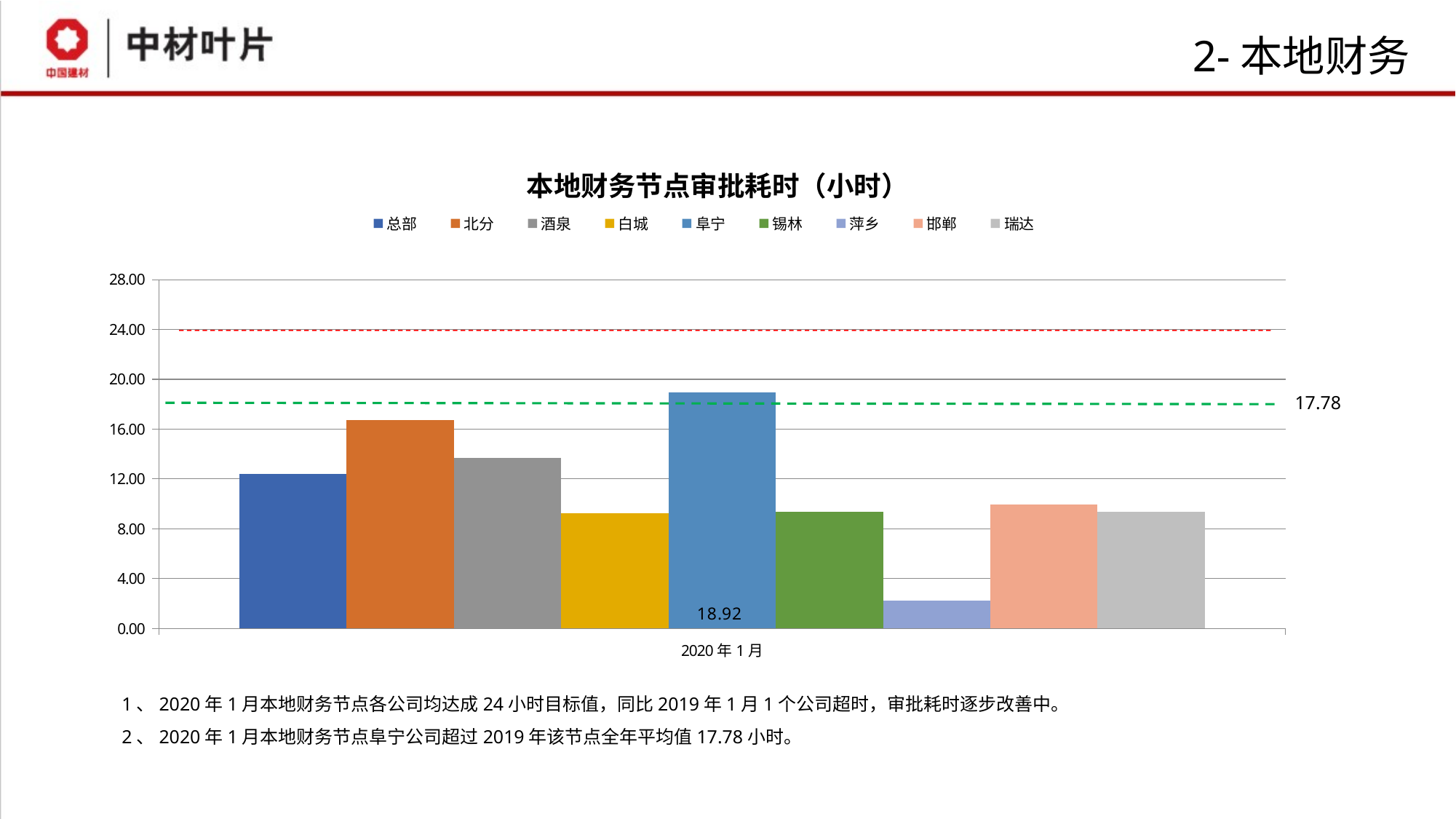
Which series has the highest value? 阜宁 Is the value for 酒泉 greater or less than 12.00? greater What is the value for 阜宁 in the chart? 18.92 Is the value for 北分 greater or less than 20.00? less By how much does the value for 阜宁 exceed the green dashed reference line value of 17.78? 1.14 Which series has the lowest value? 萍乡 Which is larger, the value for 北分 or the value for 酒泉? 北分 What value is labelled on the green dashed reference line? 17.78 What kind of chart is shown on the slide? bar chart Is the value for 萍乡 greater or less than 4.00? less Which is larger, the value for 总部 or the value for 酒泉? 酒泉 How many series does the legend list? 9